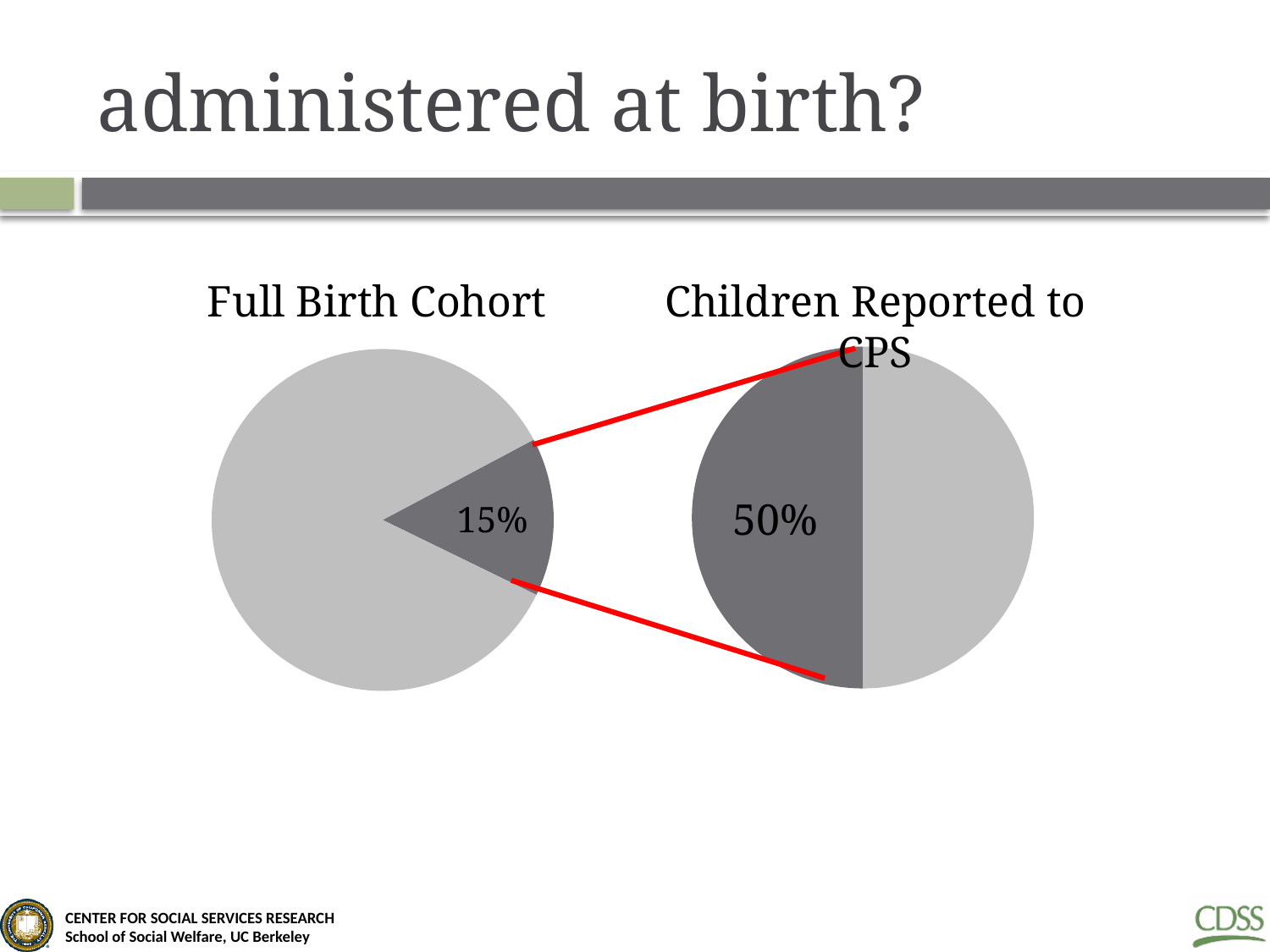
What kind of chart is used for the Full Birth Cohort? Pie chart How many pie charts are shown on the slide? 2 In the Children Reported to CPS pie chart, what percentage is shown for the dark slice? 50% How many slices does the Full Birth Cohort pie chart have? 2 In the Children Reported to CPS pie chart, what share of the pie does the light grey slice represent? 50% Which pie chart has the larger dark slice, Full Birth Cohort or Children Reported to CPS? Children Reported to CPS What is the difference in percentage points between the dark slice in the Children Reported to CPS chart and the dark slice in the Full Birth Cohort chart? 35 percentage points In the Full Birth Cohort pie chart, what percentage is shown for the dark slice? 15% How many slices does the Children Reported to CPS pie chart have? 2 What kind of chart is used for Children Reported to CPS? Pie chart What is the title of the pie chart on the left? Full Birth Cohort In the Full Birth Cohort pie chart, what share of the pie does the light grey slice represent? 85%